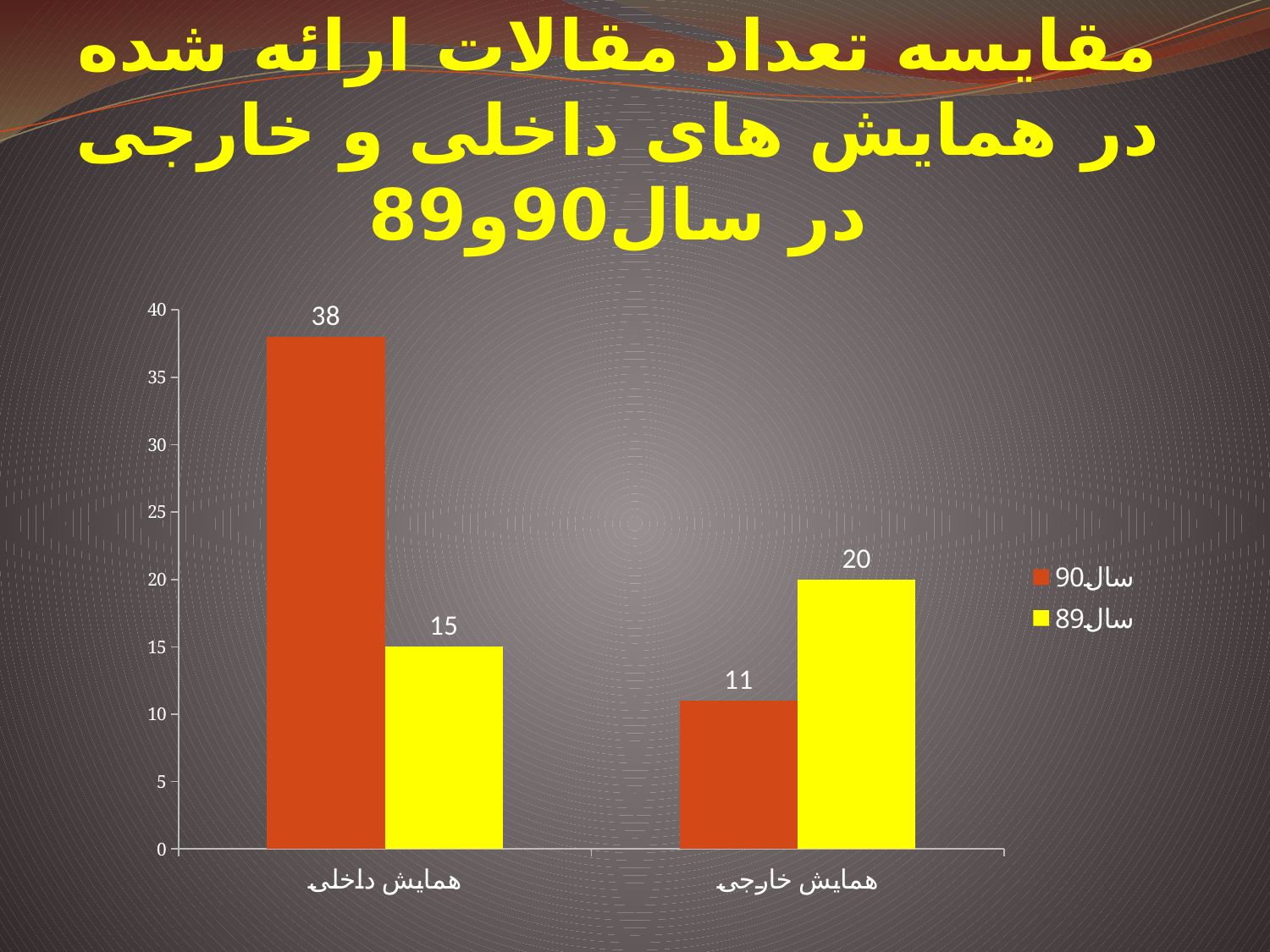
Which category has the highest value for the سال90 series? همایش داخلی In the همایش خارجی category, which series has the larger value, سال90 or سال89? سال89 What is the value for سال90 in the همایش داخلی category? 38 How many series does the legend list? 2 What kind of chart is shown on the slide? Bar chart What is the difference between the سال90 and سال89 values in the همایش داخلی category? 23 Which category has the lowest value for the سال89 series? همایش داخلی How many categories are shown on the x axis? 2 What is the value for سال90 in the همایش خارجی category? 11 What is the value for سال89 in the همایش خارجی category? 20 What is the value for سال89 in the همایش داخلی category? 15 What colour are the bars for the سال89 series? Yellow